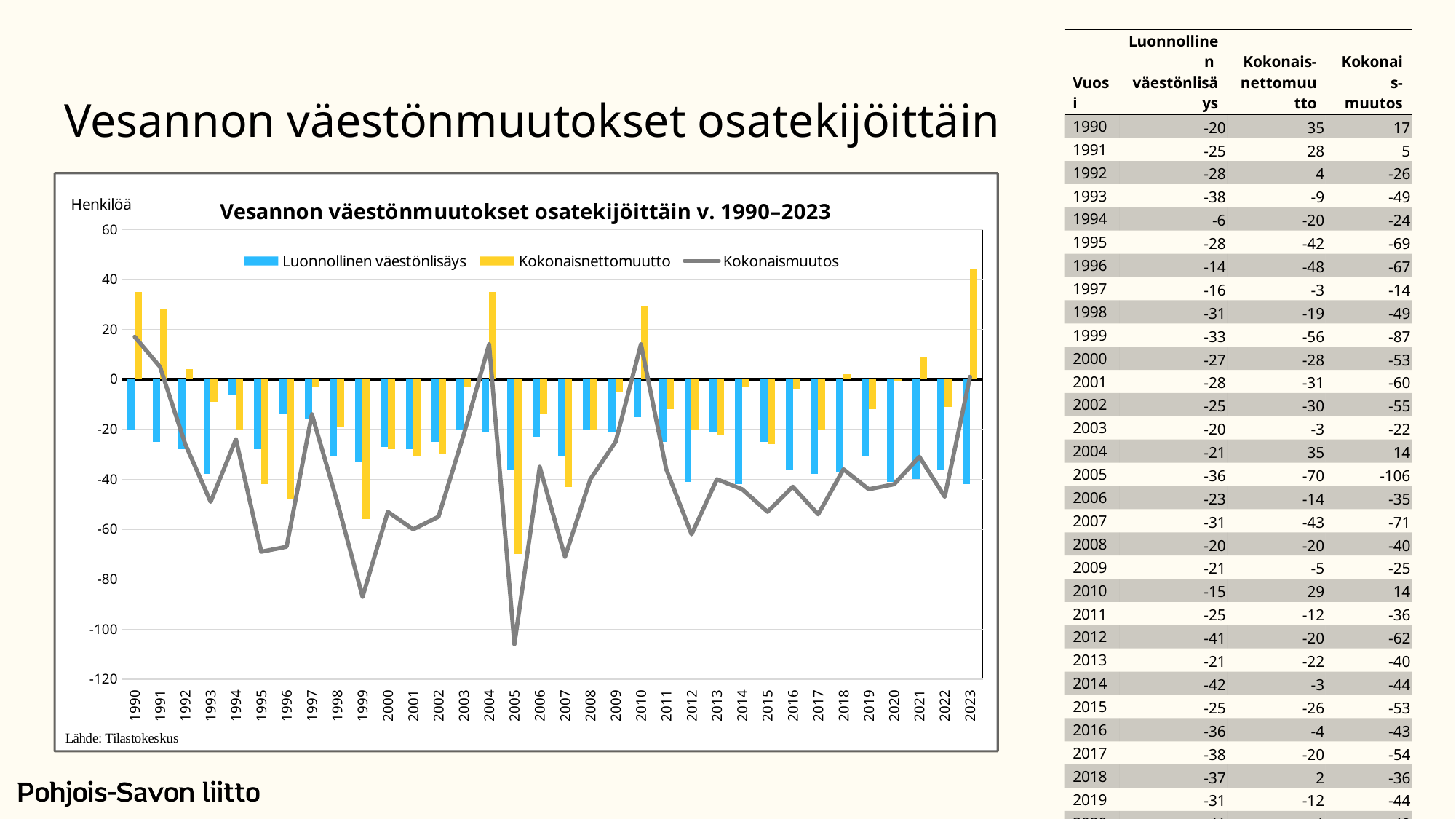
Is the Kokonaisnettomuutto value for 2023 greater or less than 20? greater Does the Kokonaismuutos line rise or fall from 2004 to 2005? fall What colour represents Kokonaisnettomuutto in the chart? Yellow In which year is the Kokonaisnettomuutto bar the highest? 2023 How many series does the chart legend list? 3 What is the Kokonaismuutos value for 2005? -106 What is the Luonnollinen väestönlisäys value for 2012? -41 How many years are shown on the x axis of the chart? 34 What kind of chart is shown on the slide? A bar chart combined with a line Which year has the larger Kokonaisnettomuutto value, 1990 or 1991? 1990 What is the difference between the Kokonaismuutos values for 2004 and 2005? 120 In which year is Kokonaismuutos at its lowest? 2005